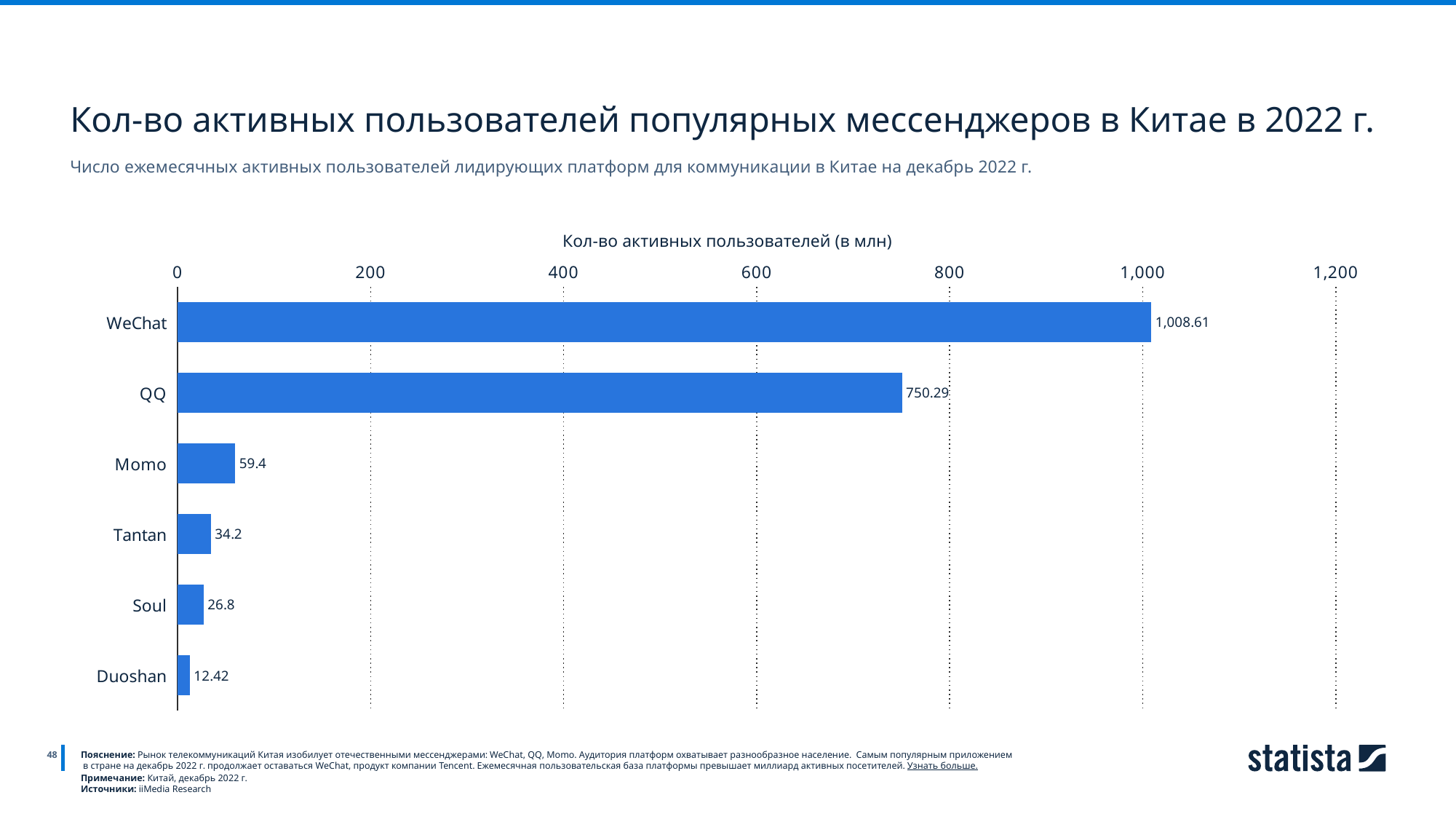
What is the difference in active users (in millions) between Tantan and Soul? 7.4 Is the value for QQ greater or less than 800? less Which has more active users, Momo or Tantan? Momo Which messenger has the lowest number of active users? Duoshan Which messenger has the highest number of active users? WeChat What is the number of active users (in millions) for Momo? 59.4 What kind of chart is shown on the slide? Bar chart How many messengers are shown in the chart? 6 What is the number of active users (in millions) for Duoshan? 12.42 What is the number of active users (in millions) for WeChat? 1,008.61 What is the difference in active users (in millions) between WeChat and QQ? 258.32 What is the number of active users (in millions) for QQ? 750.29